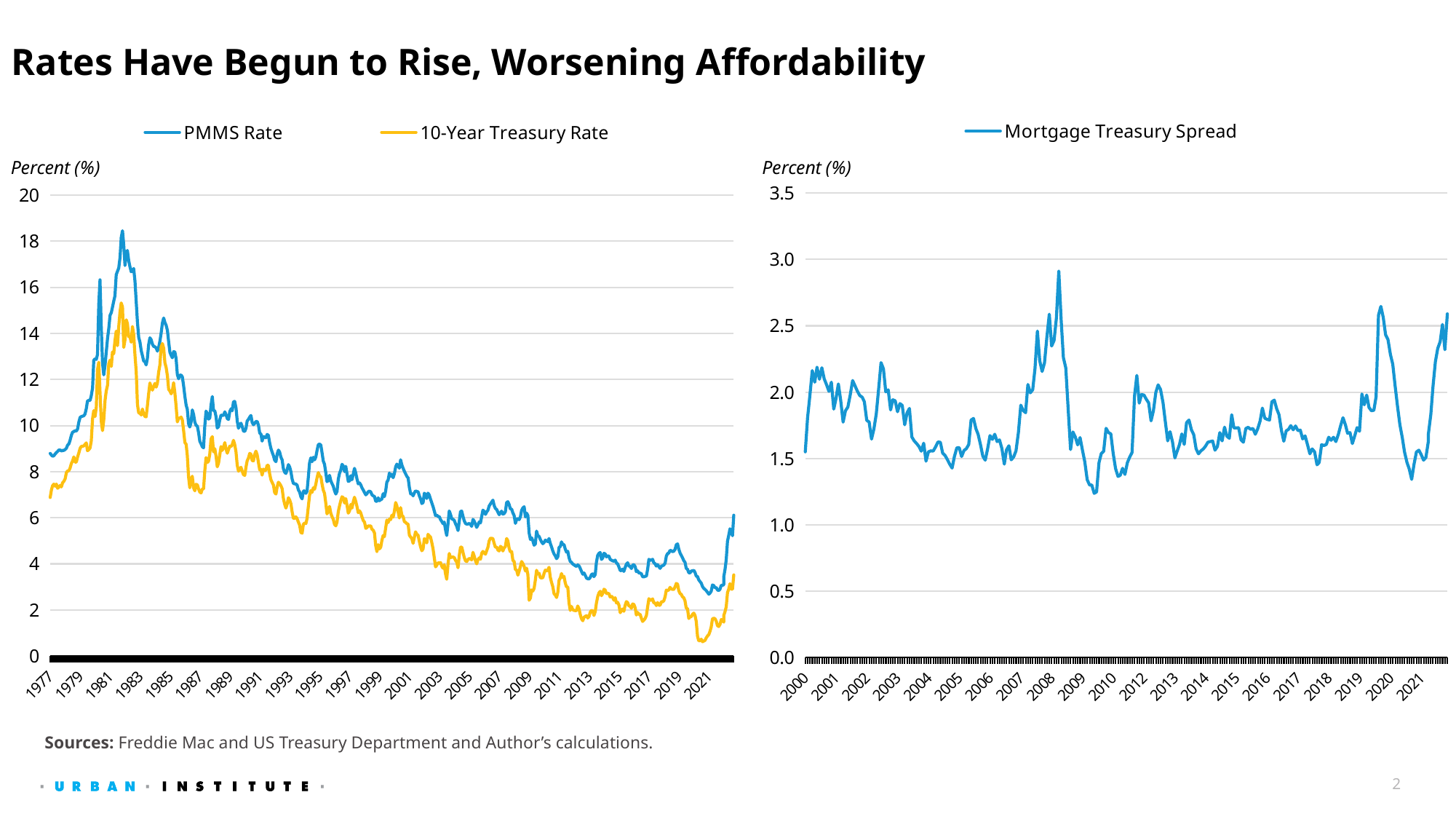
In the left chart, is the peak value of the PMMS Rate around 1981 greater or less than 16? greater How many series does the legend of the left chart list? 2 What kind of chart is the left chart showing the PMMS Rate and 10-Year Treasury Rate? line chart What is the y-axis label on the left chart? Percent (%) In the left chart, is the 10-Year Treasury Rate in 2020 greater or less than 2? less In the right chart, is the lowest value of the Mortgage Treasury Spread around 2009 greater or less than 1.5? less In the left chart, which series is higher in 1981, the PMMS Rate or the 10-Year Treasury Rate? PMMS Rate How many series does the legend of the right chart list? 1 What kind of chart is the right chart titled Mortgage Treasury Spread? line chart In the left chart, does the PMMS Rate generally rise or fall from 1981 to 2020? fall Which series in the left chart is drawn in yellow? 10-Year Treasury Rate